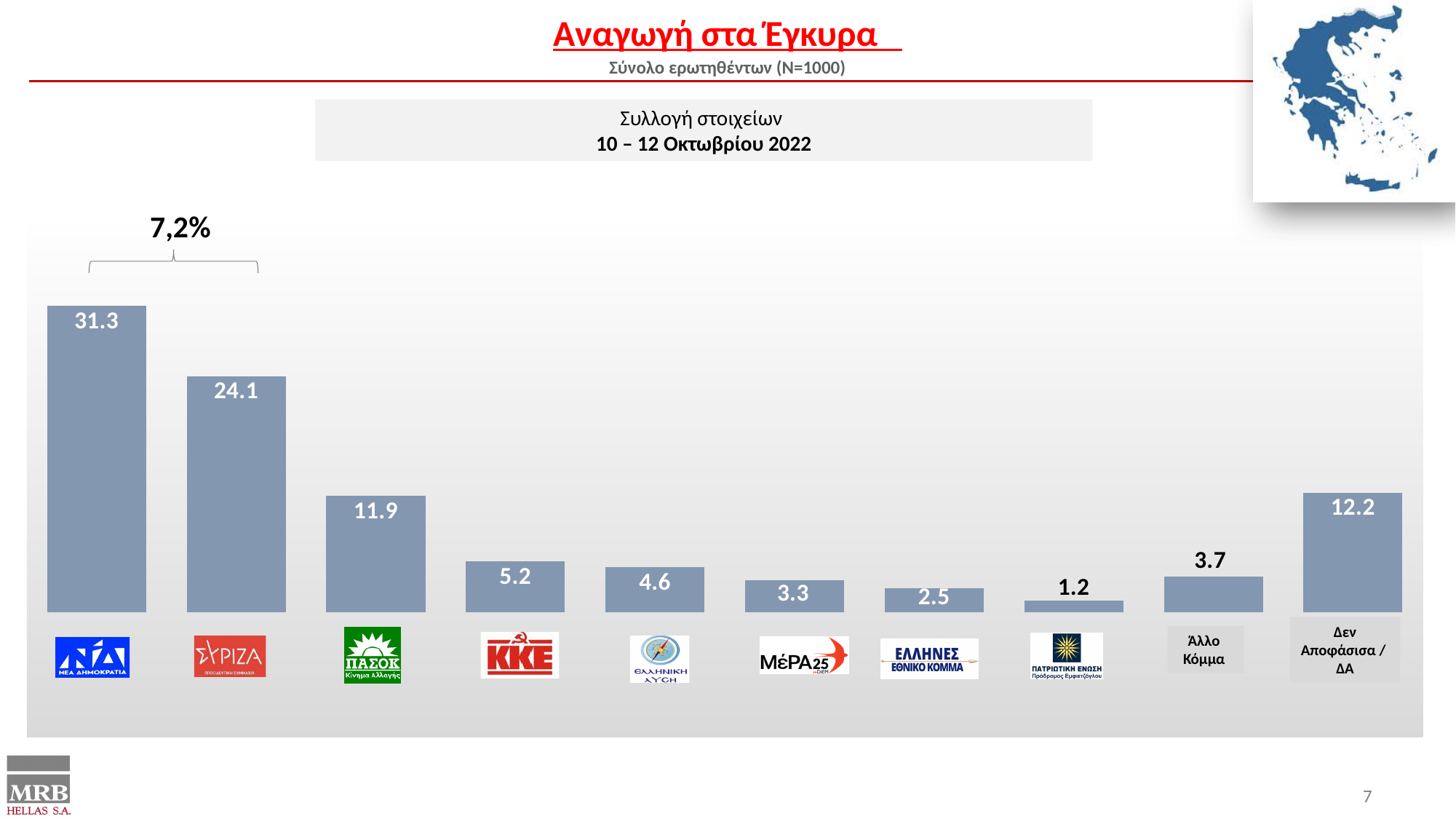
What is the value shown for ΣΥΡΙΖΑ? 24.1 What is the value shown for Νέα Δημοκρατία (ΝΔ)? 31.3 What is the title of the slide? Αναγωγή στα Έγκυρα What is the value shown for 'Δεν Αποφάσισα / ΔΑ'? 12.2 What is the difference between the values for Νέα Δημοκρατία and ΣΥΡΙΖΑ? 7.2 What is the value shown for ΠΑΣΟΚ? 11.9 Which category has the lowest value in the chart? Πατριωτική Ένωση Which category has the highest value in the chart? Νέα Δημοκρατία (ΝΔ) How many categories (bars) are shown in the chart? 10 What kind of chart is shown on the slide? Bar chart What is the value shown for ΚΚΕ? 5.2 Which is larger, the value for ΠΑΣΟΚ or the value for 'Δεν Αποφάσισα / ΔΑ'? Δεν Αποφάσισα / ΔΑ